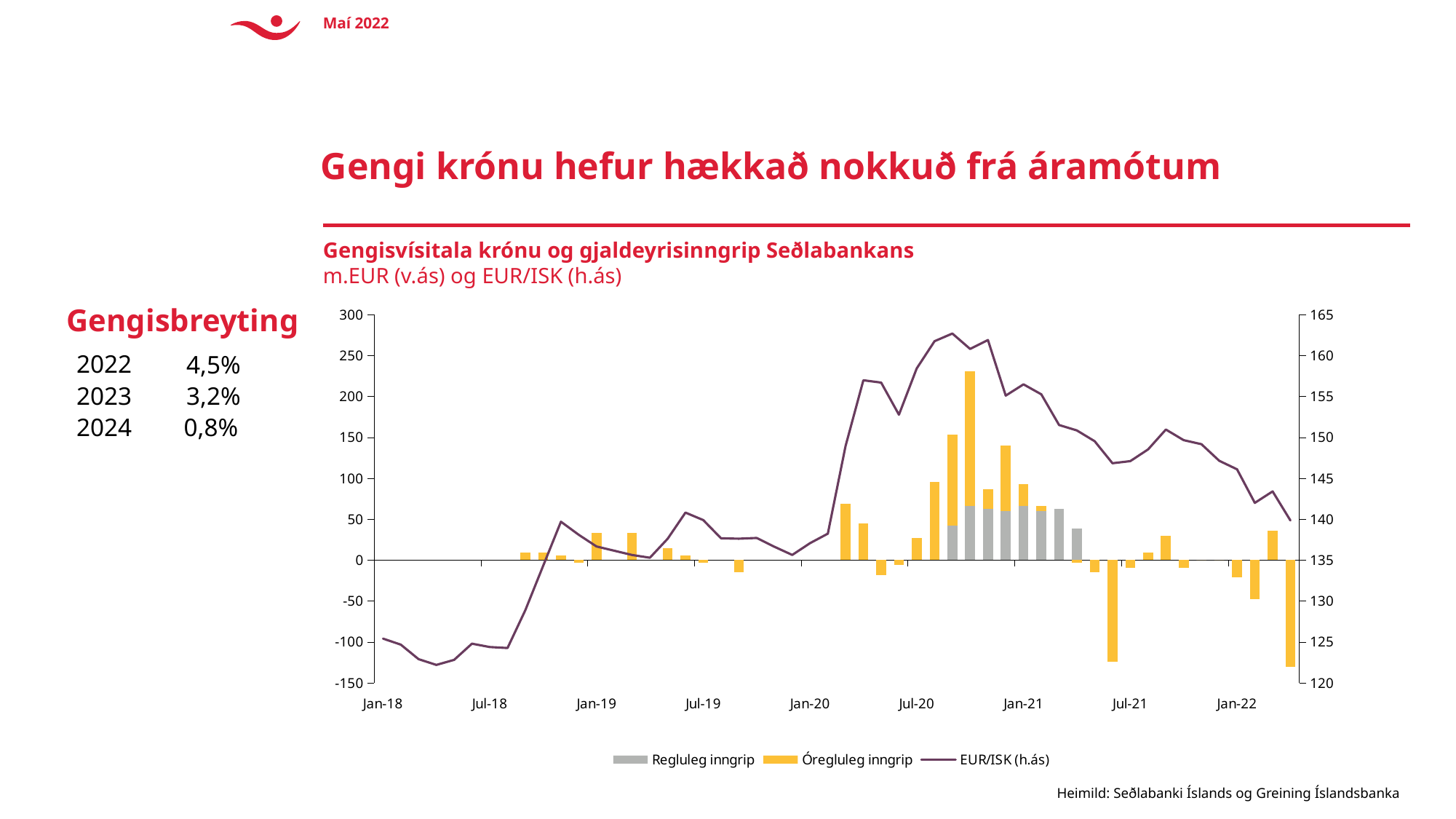
Which series is plotted on the right-hand axis? EUR/ISK (h.ás) Is the EUR/ISK line higher at Jan-18 or at Jan-21? Jan-21 Does the EUR/ISK line rise or fall between Jan-22 and the end of the series? fall Is the peak of the EUR/ISK line in late 2020 greater or less than 160 on the right axis? greater How many series does the chart legend list? 3 Is the most negative bar at the right end of the chart greater or less than -100 on the left axis? less What is the title of the chart? Gengisvísitala krónu og gjaldeyrisinngrip Seðlabankans What kind of chart is shown on the slide? Combined bar and line chart Is the EUR/ISK value at Jan-18 greater or less than 130 on the right axis? less Does the EUR/ISK line rise or fall between Jan-20 and Jul-20? rise